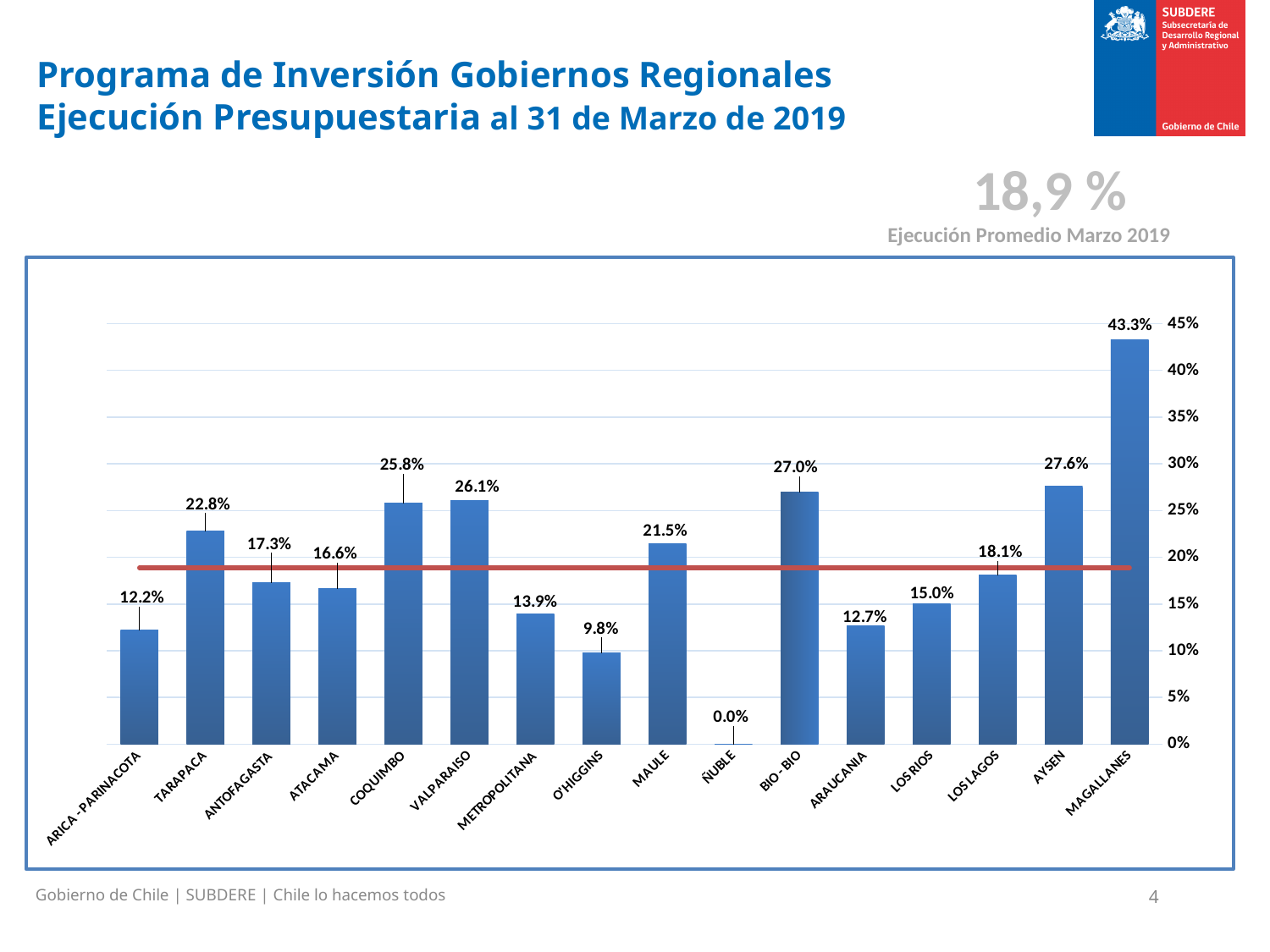
How many regions are shown on the x axis? 16 What is the value for MAGALLANES? 43.3% What kind of chart is shown on the slide? bar chart Which is larger, the value for BIO - BIO or the value for VALPARAISO? BIO - BIO What is the difference between the values for MAGALLANES and AYSEN? 15.7% What is the difference between the values for TARAPACA and ARICA - PARINACOTA? 10.6% What is the value for ÑUBLE? 0.0% What is the value for COQUIMBO? 25.8% Which region has the highest value? MAGALLANES Which region has the lowest value? ÑUBLE What average value does the red horizontal line represent, according to the text above the chart? 18,9 % Is the value for O'HIGGINS greater or less than 10%? less